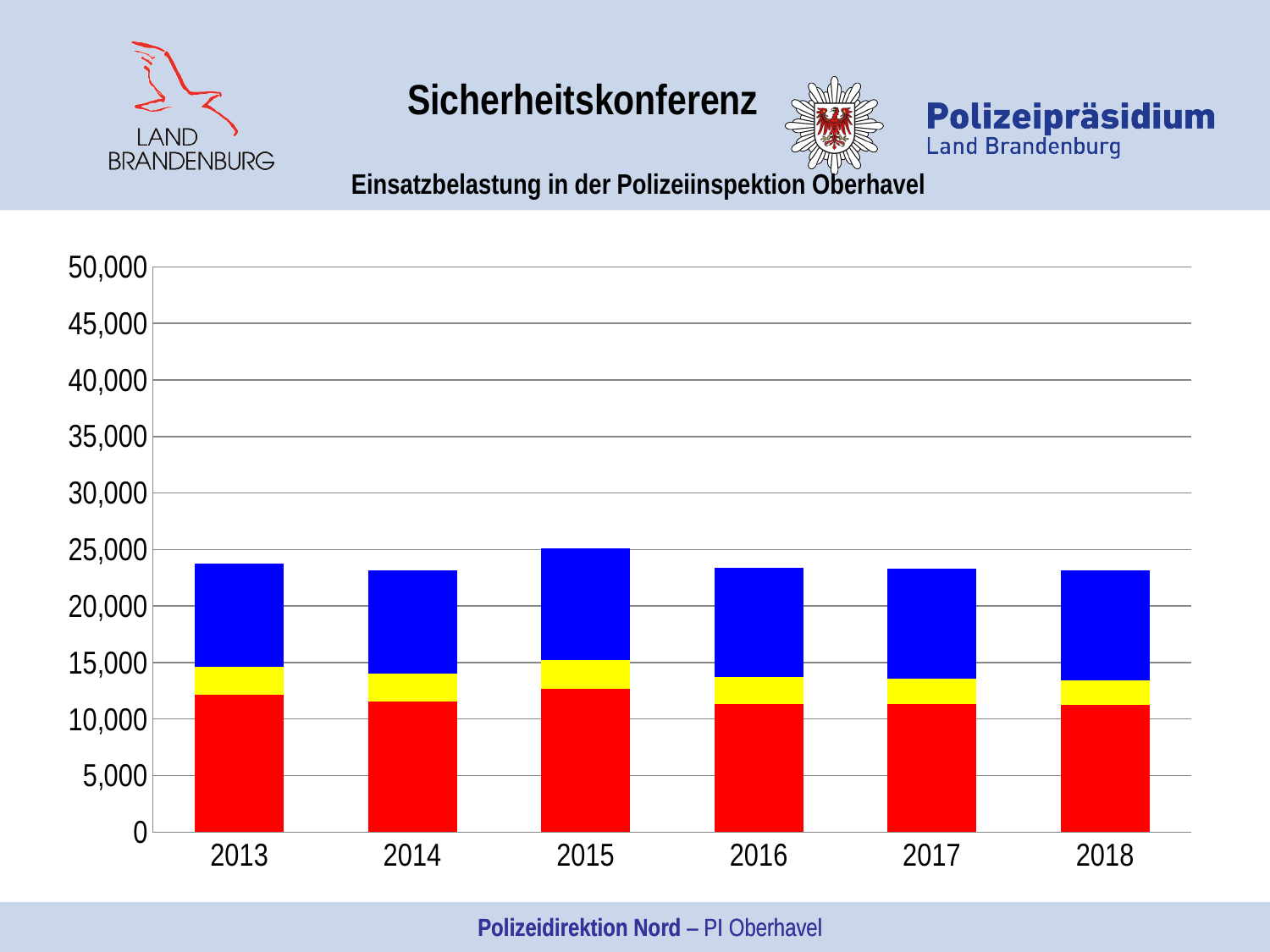
Which year has the highest total stacked bar in the chart? 2015 How many coloured segments make up each stacked bar in the chart? 3 Is the total stacked bar for 2014 greater or less than 25,000? less What is the title of the chart on the slide? Einsatzbelastung in der Polizeiinspektion Oberhavel How many years are shown on the x axis of the chart? 6 Is the red segment for 2013 greater or less than 10,000? greater Is the total stacked bar for 2013 greater or less than 25,000? less Which year has the larger total stacked bar, 2014 or 2015? 2015 What kind of chart is shown on the slide? stacked bar chart Which year has the larger red segment, 2015 or 2018? 2015